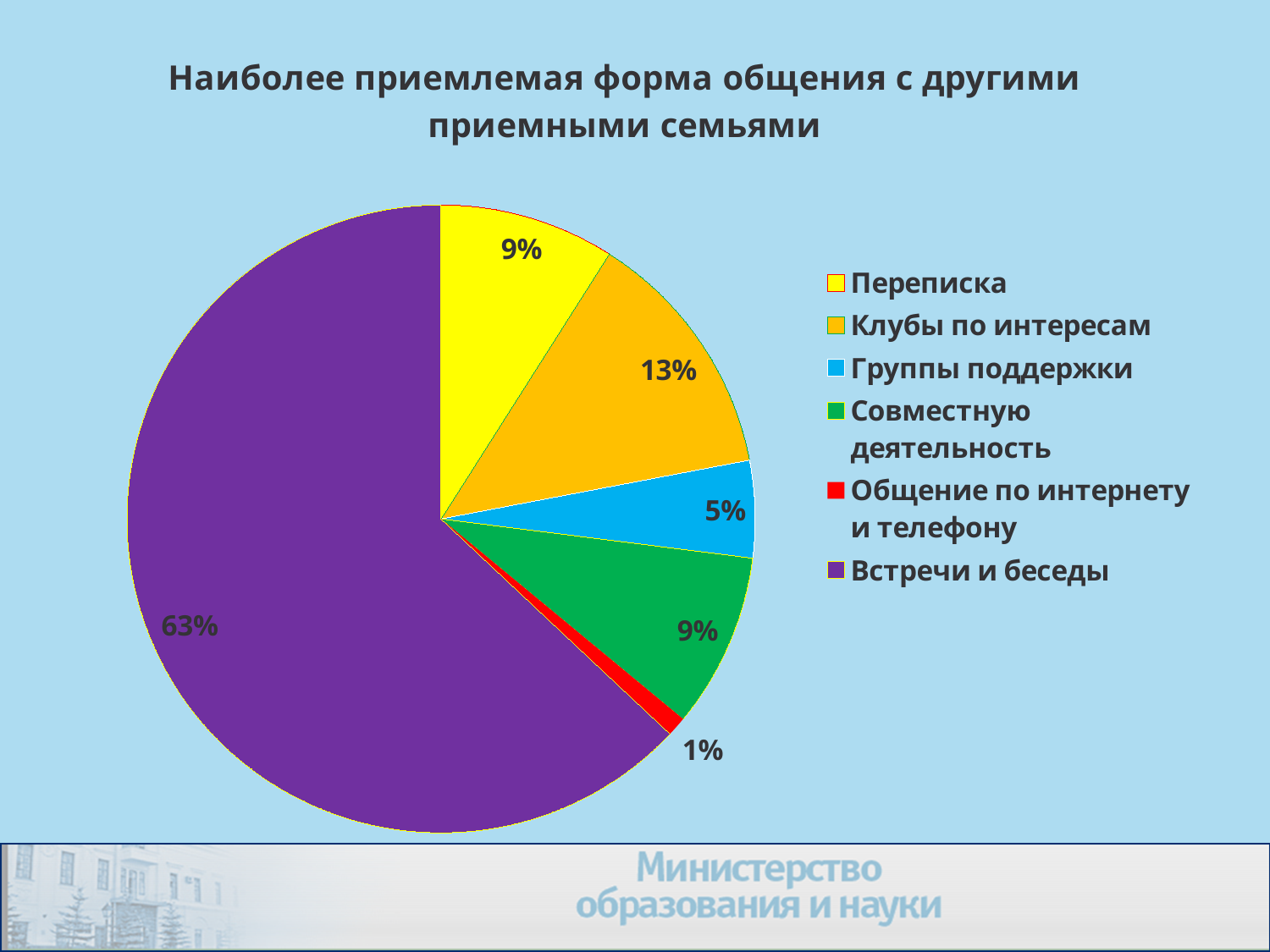
What is the share for Группы поддержки? 5% What is the share for Встречи и беседы? 63% What is the share for Общение по интернету и телефону? 1% What colour is the slice for Переписка? yellow What is the share for Клубы по интересам? 13% What is the title of the chart? Наиболее приемлемая форма общения с другими приемными семьями How many categories does the legend list? 6 What type of chart is shown on the slide? pie chart What is the difference between the shares for Встречи и беседы and Клубы по интересам? 50% Which is larger: the share for Клубы по интересам or the share for Группы поддержки? Клубы по интересам Which category has the largest slice of the pie? Встречи и беседы Which category has the smallest slice of the pie? Общение по интернету и телефону